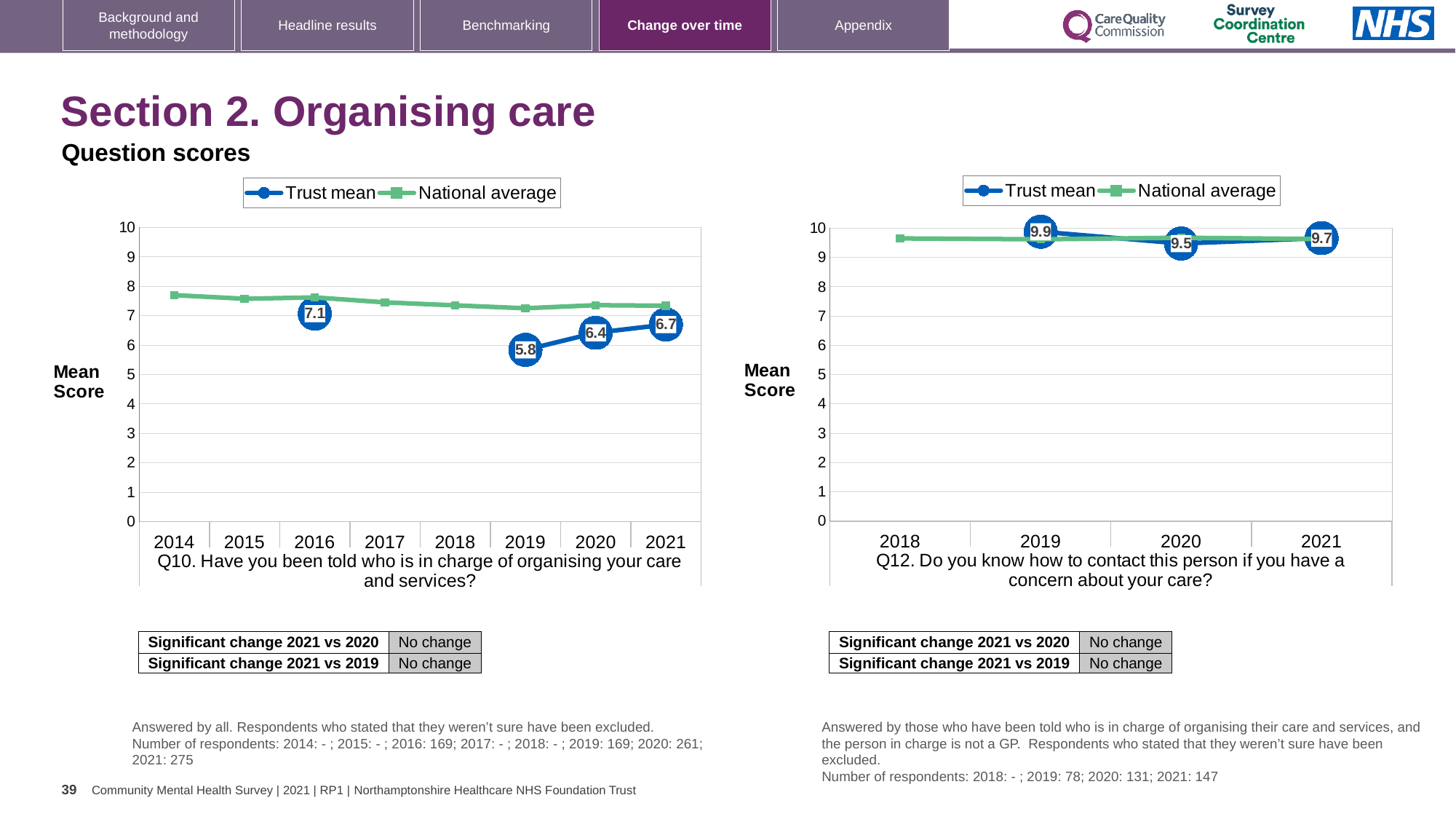
In the Q10 chart on the left, how many years are shown on the x axis? 8 In the Q12 chart on the right, how many series does the legend list? 2 In the Q10 chart on the left, which year has the lowest labelled Trust mean score? 2019 In the Q10 chart on the left, what is the Trust mean score for 2016? 7.1 In the Q12 chart on the right, is the Trust mean for 2019 larger or smaller than the Trust mean for 2020? larger In the Q12 chart on the right, what is the Trust mean score for 2020? 9.5 What type of chart is the Q12 chart on the right? Line chart In the Q10 chart on the left, what is the Trust mean score for 2019? 5.8 In the Q10 chart on the left, is the National average for 2014 greater or less than 7? greater In the Q10 chart on the left, what is the difference between the Trust mean scores for 2021 and 2019? 0.9 In the Q10 chart on the left, what is the Trust mean score for 2021? 6.7 In the Q12 chart on the right, which year has the highest labelled Trust mean score? 2019